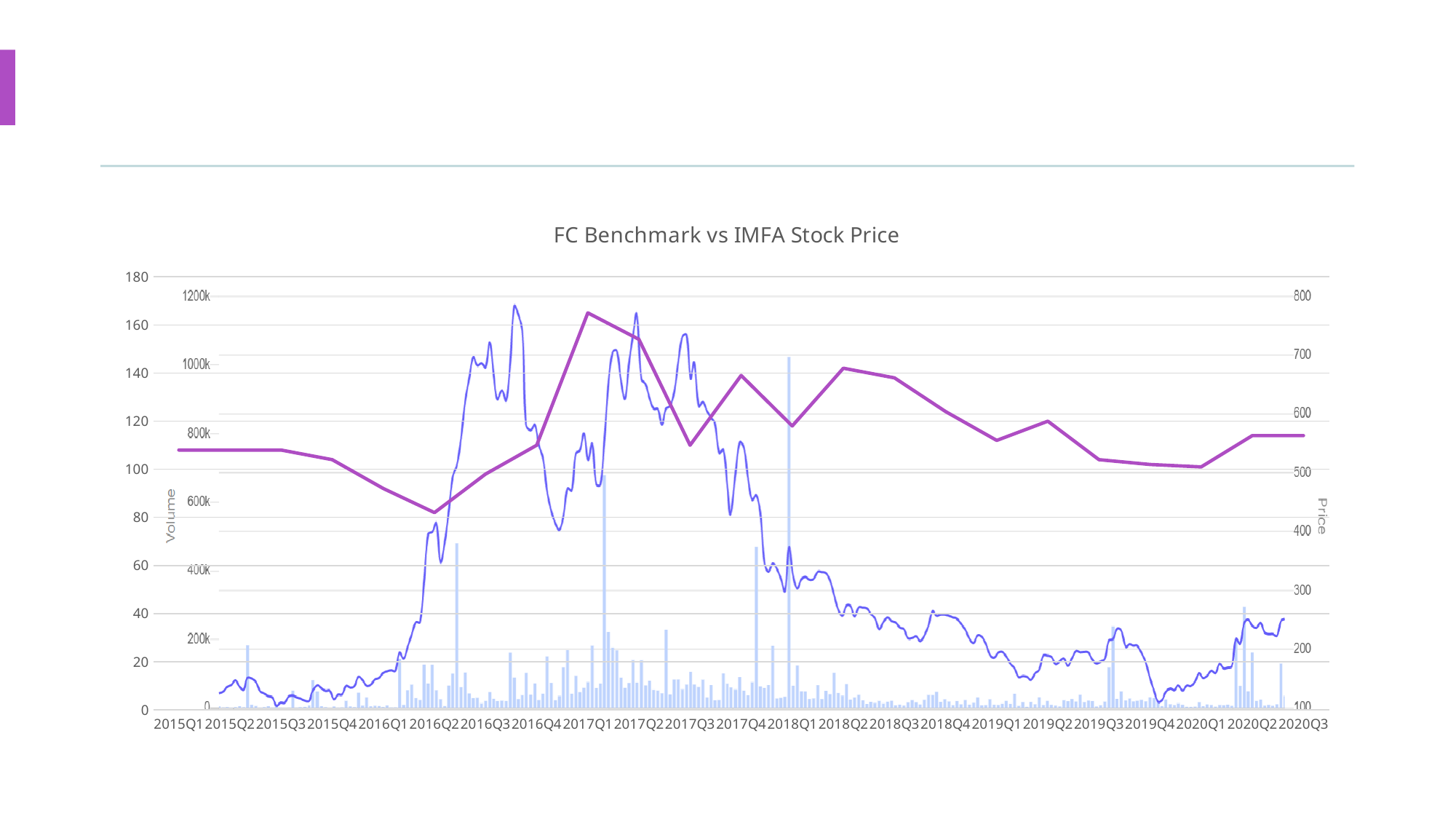
Which is higher on the purple line, the value at 2015Q1 or the value at 2016Q1? 2015Q1 How many quarters are labelled along the x axis? 23 Is the value of the purple line at 2018Q2 greater or less than 120 on the left axis? greater Does the purple line rise or fall between 2016Q1 and 2017Q1? rise At which quarter does the purple line reach its highest point? 2017Q1 Is the value of the purple line at 2017Q1 greater or less than 140 on the left axis? greater Does the purple line rise or fall between 2017Q1 and 2017Q3? fall At which quarter does the purple line reach its lowest point? 2016Q2 What is the label on the right-hand vertical axis? Price Is the value of the purple line at 2015Q1 greater or less than 100 on the left axis? greater What is the title of the chart? FC Benchmark vs IMFA Stock Price